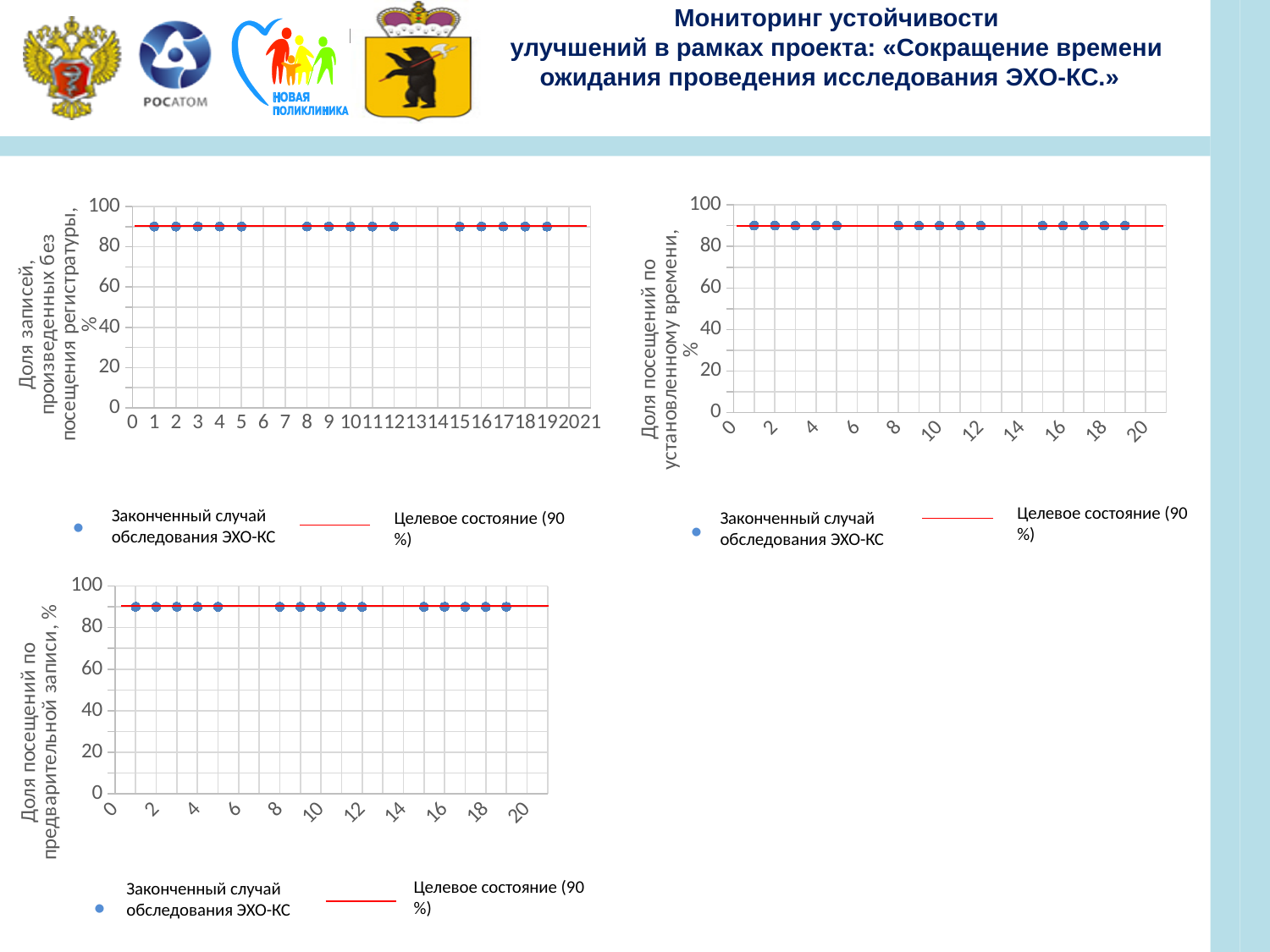
What is the highest value shown on the y axis of the bottom-left chart? 100 In the top-right chart, do the plotted values rise, fall, or stay roughly flat along the x axis? stay roughly flat In the bottom-left chart, is the value for x = 16 greater or less than 100? less What kind of chart is the top-left chart on the slide? scatter chart In the top-right chart, is the value for x = 10 greater or less than 60? greater How many series does the legend of the top-right chart list? 2 What is the name of the series shown with blue dots in the bottom-left chart? Законченный случай обследования ЭХО-КС In the top-left chart, is the value for x = 5 greater or less than 80? greater How many data points are plotted in the top-left chart? 15 What is the y-axis title of the top-right chart? Доля посещений по установленному времени, % What target value does the red line in the top-left chart represent, according to the legend? 90 % In the bottom-left chart, do the plotted values rise, fall, or stay roughly flat along the x axis? stay roughly flat